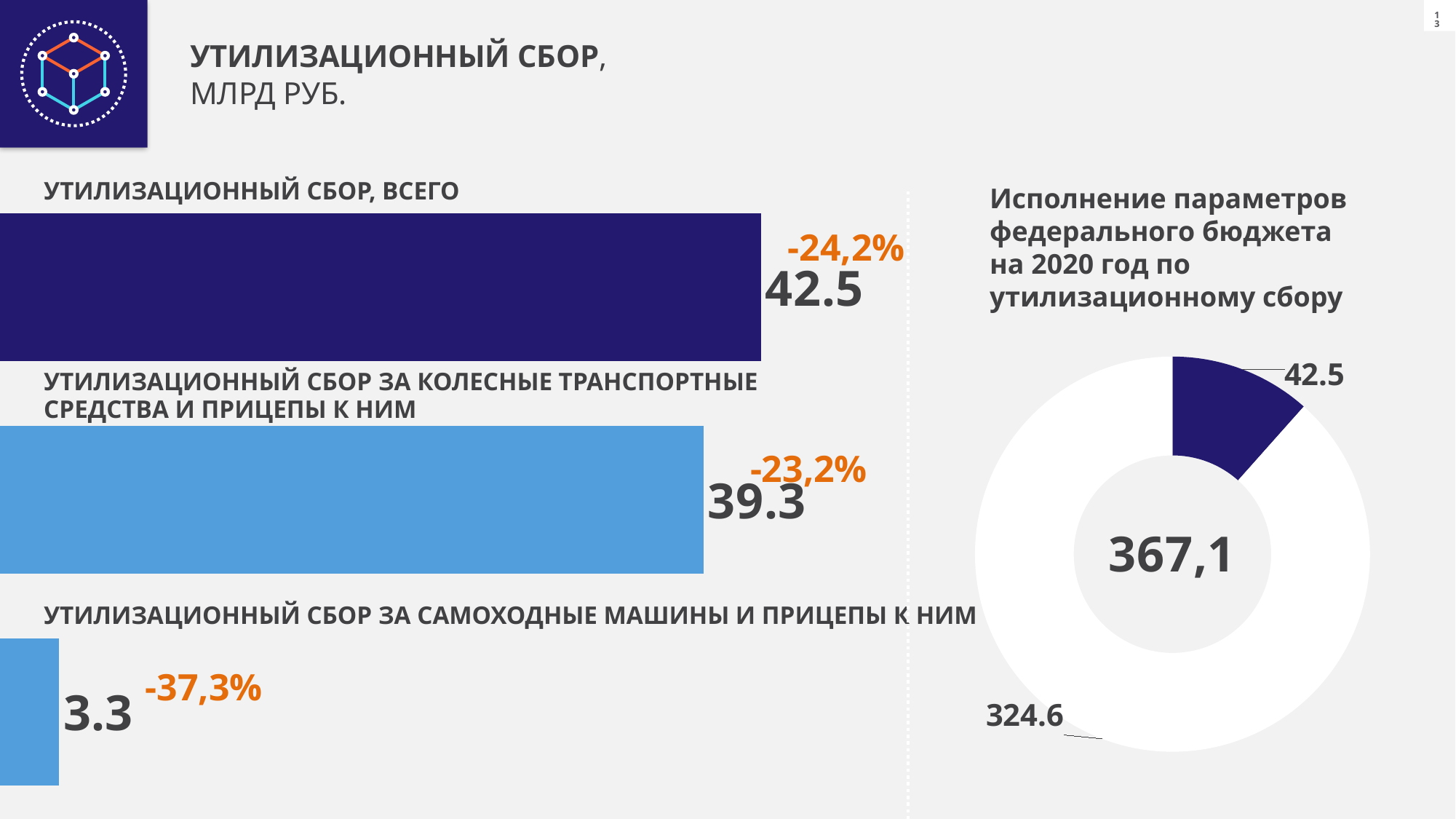
On the right donut chart, what value is shown in the centre? 367,1 On the left bar chart, what percentage change is shown next to the bar for 'Утилизационный сбор, всего'? -24,2% On the left bar chart, which is larger: the value for 'Утилизационный сбор за колесные транспортные средства и прицепы к ним' or the value for 'Утилизационный сбор за самоходные машины и прицепы к ним'? Утилизационный сбор за колесные транспортные средства и прицепы к ним On the right donut chart, what is the value of the larger (white) slice? 324.6 On the left bar chart, what percentage change is shown next to the bar for 'Утилизационный сбор за самоходные машины и прицепы к ним'? -37,3% On the left bar chart, what is the difference between the value for 'Утилизационный сбор, всего' and the value for 'Утилизационный сбор за колесные транспортные средства и прицепы к ним'? 3.2 On the left bar chart, which category has the lowest value? Утилизационный сбор за самоходные машины и прицепы к ним On the left bar chart, what is the value for 'Утилизационный сбор за колесные транспортные средства и прицепы к ним'? 39.3 What kind of chart is shown on the left side of the slide? Bar chart What kind of chart is shown on the right side of the slide? Donut chart On the left bar chart, what is the value for 'Утилизационный сбор за самоходные машины и прицепы к ним'? 3.3 On the left bar chart, what is the value for 'Утилизационный сбор, всего'? 42.5